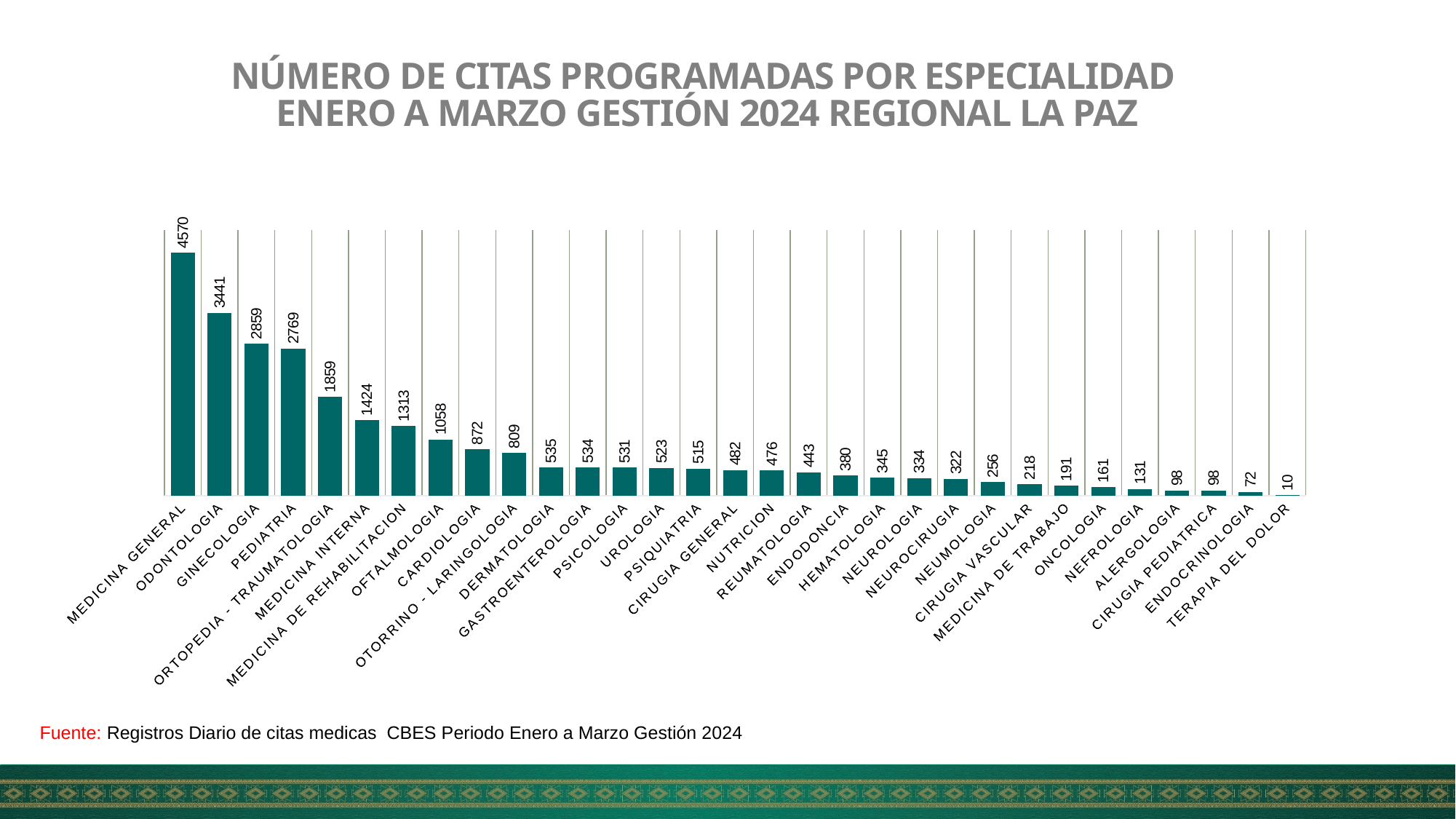
What is the title of the chart? NÚMERO DE CITAS PROGRAMADAS POR ESPECIALIDAD ENERO A MARZO GESTIÓN 2024 REGIONAL LA PAZ Which specialty has the lowest number of scheduled appointments? TERAPIA DEL DOLOR Which has a larger value, PEDIATRIA or ORTOPEDIA - TRAUMATOLOGIA? PEDIATRIA What is the difference between the values for MEDICINA INTERNA and MEDICINA DE REHABILITACION? 111 What is the difference between the values for ODONTOLOGIA and GINECOLOGIA? 582 How many specialties (categories) are plotted in the chart? 31 What is the value shown for NEUMOLOGIA? 256 What is the number of scheduled appointments for MEDICINA GENERAL? 4570 Do the values rise or fall moving from left to right along the x axis? fall Which specialty has the highest number of scheduled appointments? MEDICINA GENERAL What type of chart is shown on the slide? bar chart What is the value shown for CARDIOLOGIA? 872